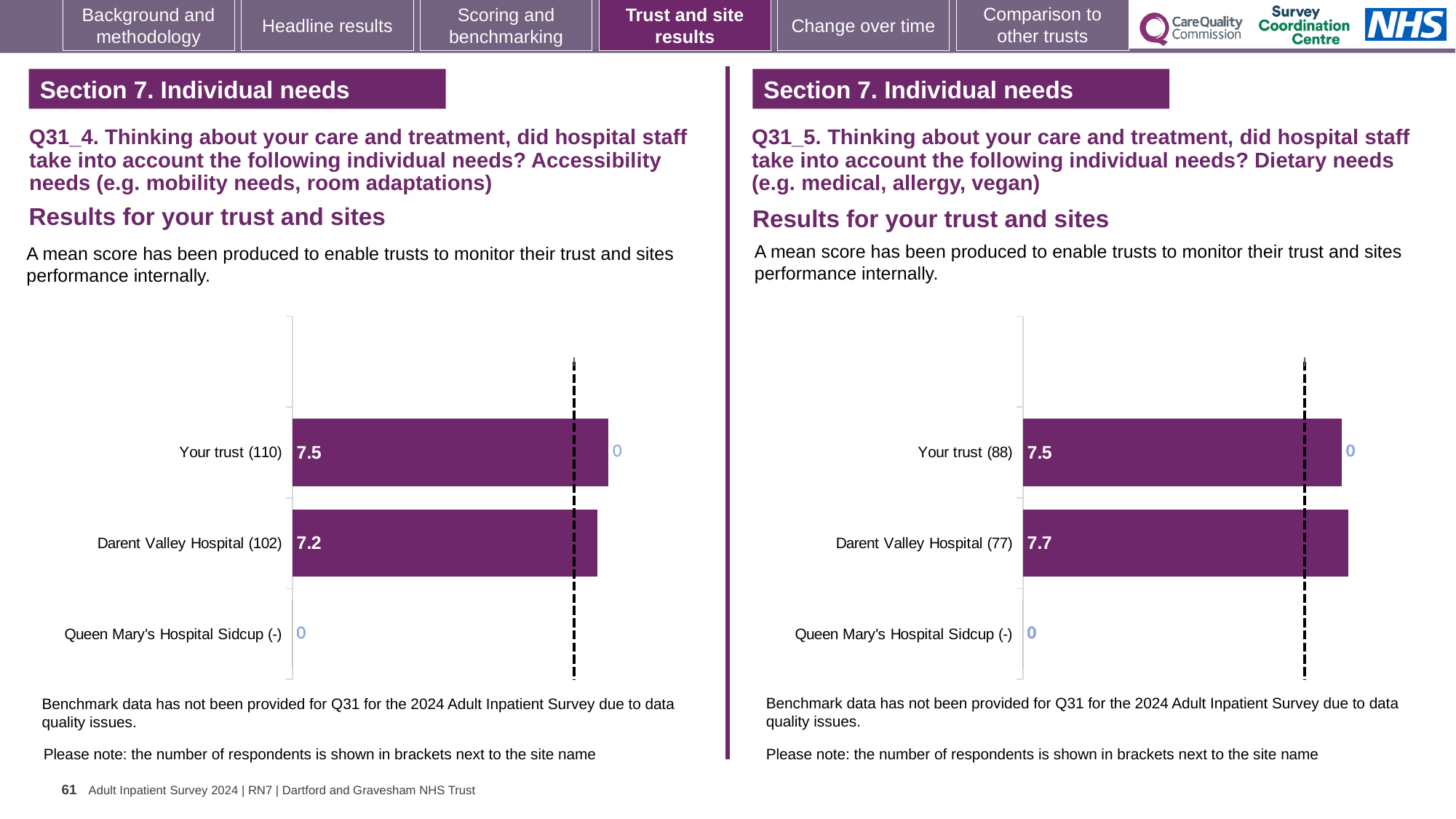
In the left chart (Q31_4, Accessibility needs), what is the mean score for Darent Valley Hospital? 7.2 What type of chart is used in the right chart (Q31_5, Dietary needs)? Bar chart In the right chart (Q31_5, Dietary needs), which has the higher score: Your trust or Darent Valley Hospital? Darent Valley Hospital In the right chart (Q31_5, Dietary needs), what is the difference between the scores for Darent Valley Hospital and Your trust? 0.2 In the left chart (Q31_4, Accessibility needs), how many respondents are shown in brackets for Your trust? 110 In the right chart (Q31_5, Dietary needs), how many respondents are shown in brackets for Darent Valley Hospital? 77 In the right chart (Q31_5, Dietary needs), what is the mean score for Your trust? 7.5 In the left chart (Q31_4, Accessibility needs), what is the mean score for Your trust? 7.5 In the right chart (Q31_5, Dietary needs), what is the mean score for Darent Valley Hospital? 7.7 In the left chart (Q31_4, Accessibility needs), what is the difference between the scores for Your trust and Darent Valley Hospital? 0.3 In the left chart (Q31_4, Accessibility needs), how many categories are shown on the vertical axis? 3 In the left chart (Q31_4, Accessibility needs), which has the higher score: Your trust or Darent Valley Hospital? Your trust